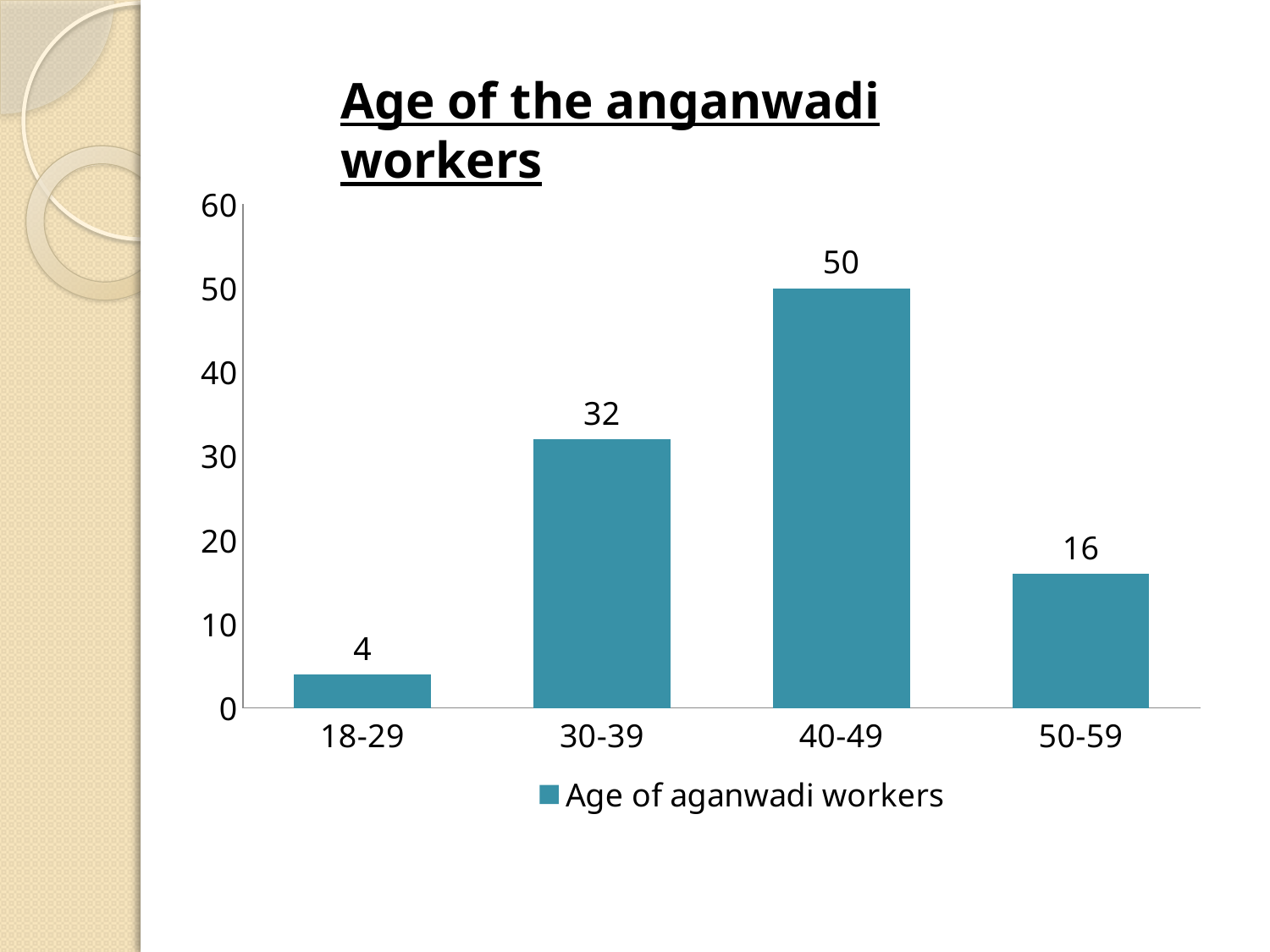
What kind of chart is shown on the slide? Bar chart Which age group has the highest value? 40-49 What is the difference between the values for the 40-49 and 30-39 age groups? 18 How many series does the legend list? 1 How many age groups are shown on the x axis? 4 What is the value for the 40-49 age group? 50 Which age group has the lowest value? 18-29 Which is larger, the value for 50-59 or the value for 18-29? 50-59 What is the value for the 30-39 age group? 32 What is the value for the 50-59 age group? 16 What is the value for the 18-29 age group? 4 What is the legend entry for the series? Age of aganwadi workers